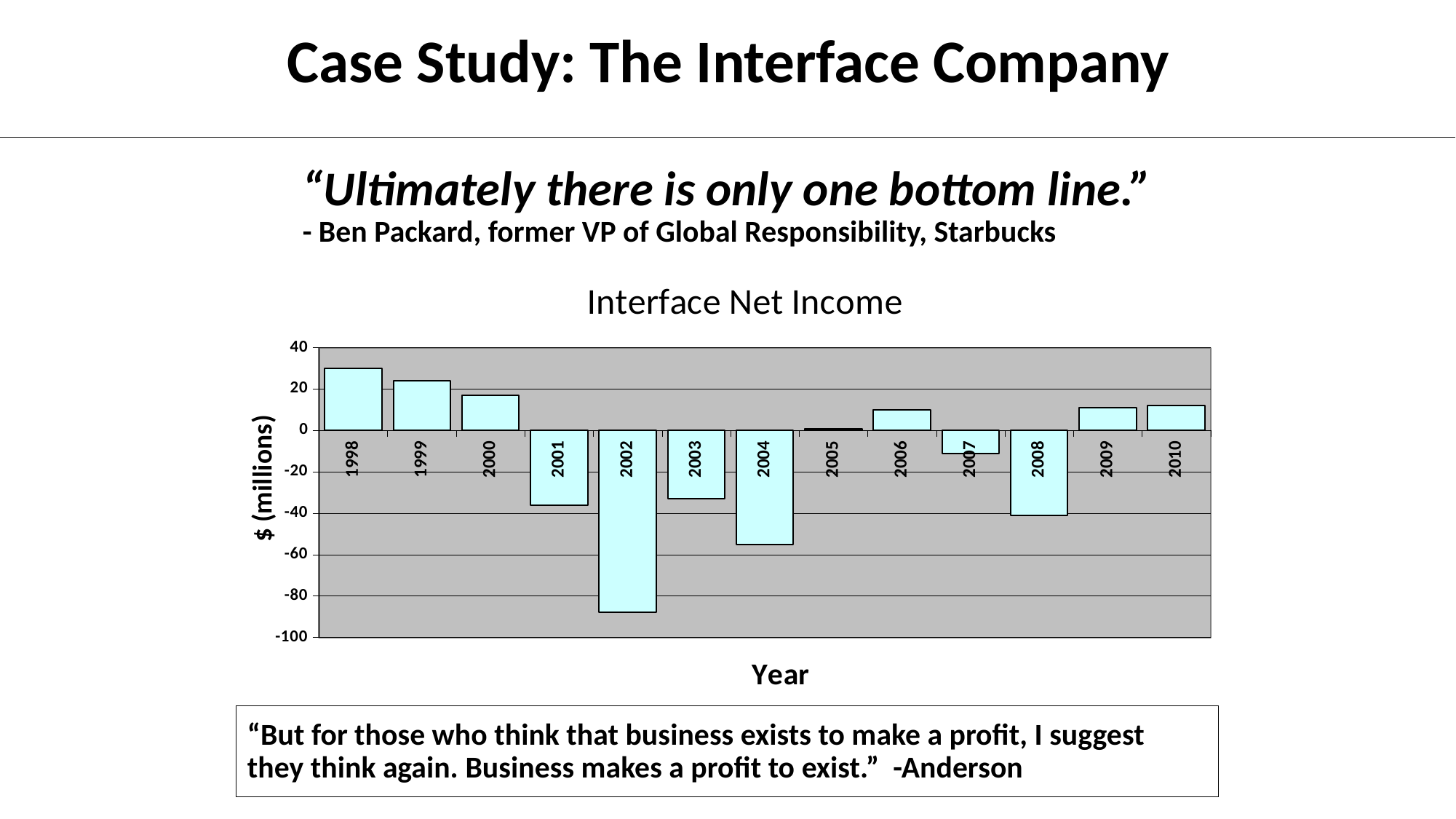
What is the label on the vertical axis of the chart? $ (millions) What kind of chart is shown on the slide? bar chart Is the net income for 2004 greater or less than -40? less How many years are plotted in the Interface Net Income chart? 13 What is the title of the chart? Interface Net Income Which year has the lowest net income in the chart? 2002 Which year has the highest net income in the chart? 1998 Is the net income for 2002 greater or less than -80? less Is the net income for 2008 greater or less than -60? greater Which year has the larger net income, 2003 or 2004? 2003 Which year has the larger net income, 1999 or 2000? 1999